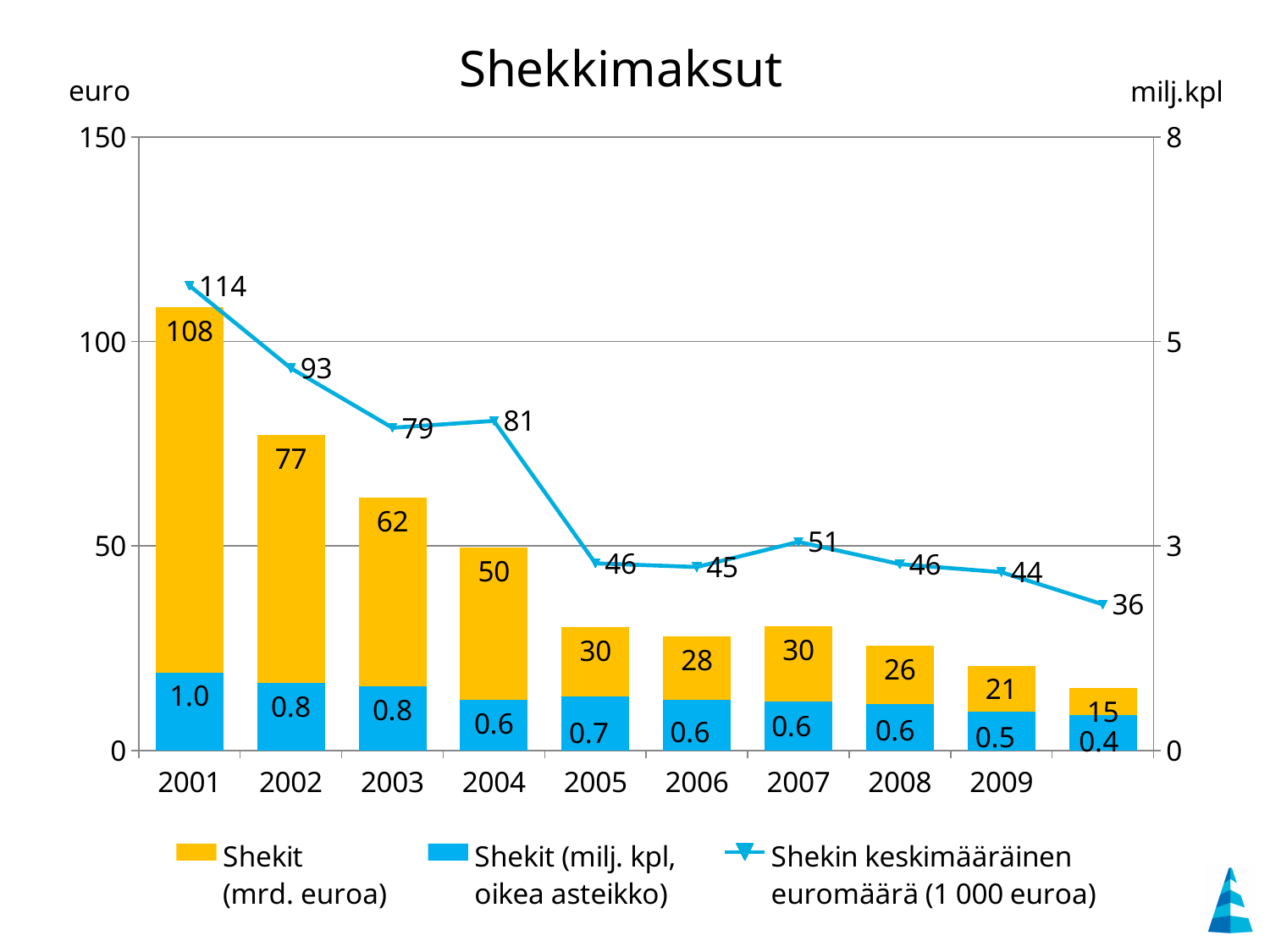
What is the difference between the Shekit (mrd. euroa) values for 2001 and 2002? 31 How many series does the legend list? 3 What is the value of Shekit (mrd. euroa) for 2001? 108 What is the value of Shekin keskimääräinen euromäärä (1 000 euroa) for 2004? 81 What is the difference between the Shekin keskimääräinen euromäärä (1 000 euroa) values for 2001 and 2009? 70 Which year has the larger Shekin keskimääräinen euromäärä (1 000 euroa) value, 2003 or 2004? 2004 What is the value of Shekit (milj. kpl, oikea asteikko) for 2005? 0.7 Of the years 2001 to 2009, which has the lowest Shekit (mrd. euroa) value? 2009 What is the title of the chart? Shekkimaksut Do the Shekit (mrd. euroa) values generally rise or fall from 2001 to 2009? Fall What kind of chart is shown on the slide? Combination bar and line chart In which year is Shekin keskimääräinen euromäärä (1 000 euroa) highest? 2001